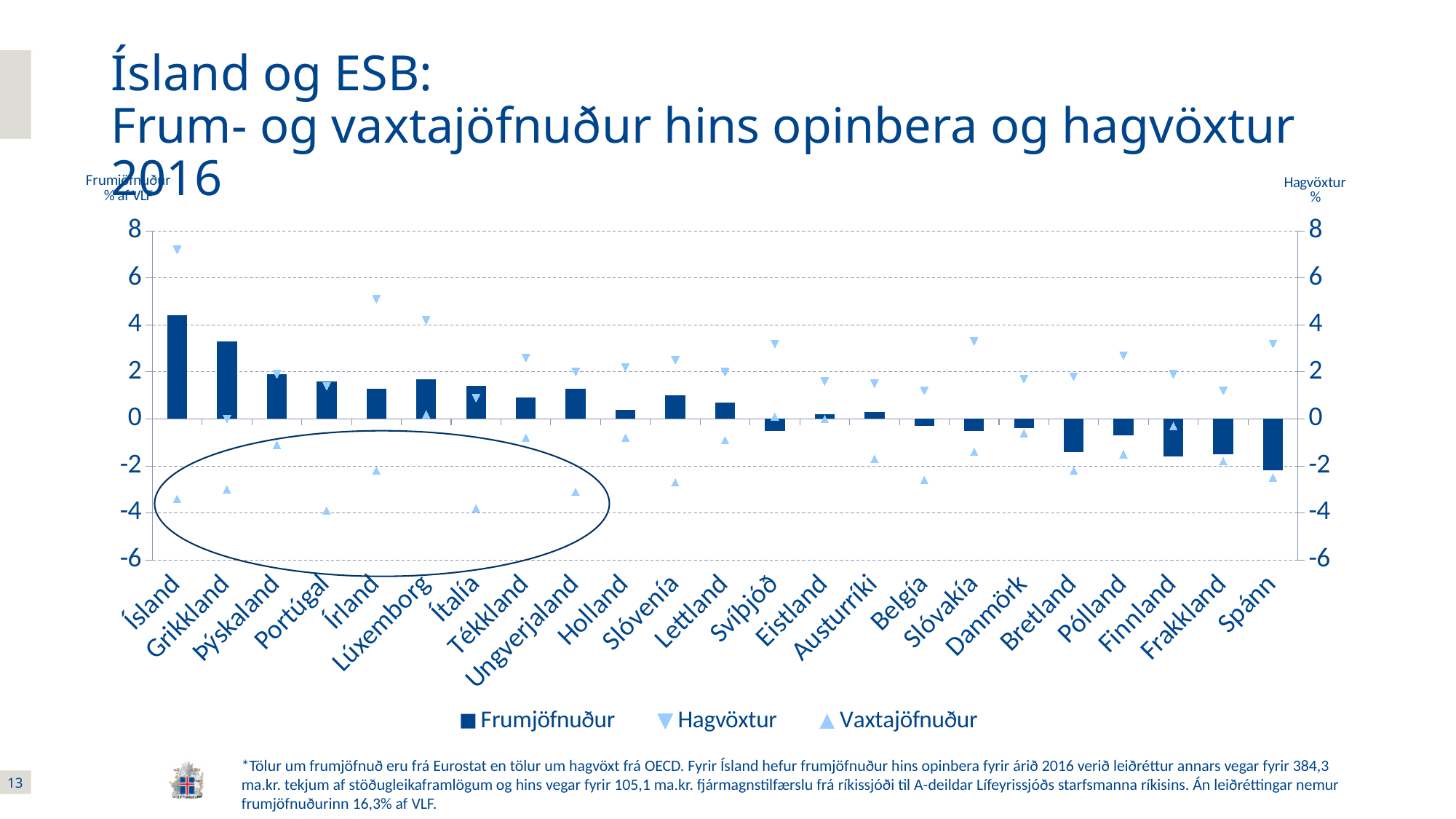
Do the Frumjöfnuður bars generally rise or fall from left to right along the x axis? fall Is the Vaxtajöfnuður value for Portúgal greater or less than -2? less Which has the larger Hagvöxtur value, Ísland or Írland? Ísland Is the Frumjöfnuður value for Grikkland greater or less than 2? greater Is the Hagvöxtur value for Ísland greater or less than 6? greater How many series does the legend list? 3 Which country has the highest Frumjöfnuður bar? Ísland How many countries are shown on the x axis of the chart? 23 Which country has the highest Hagvöxtur marker? Ísland What kind of chart is shown on the slide? Bar chart (with scatter markers) Which country has the lowest Frumjöfnuður bar? Spánn